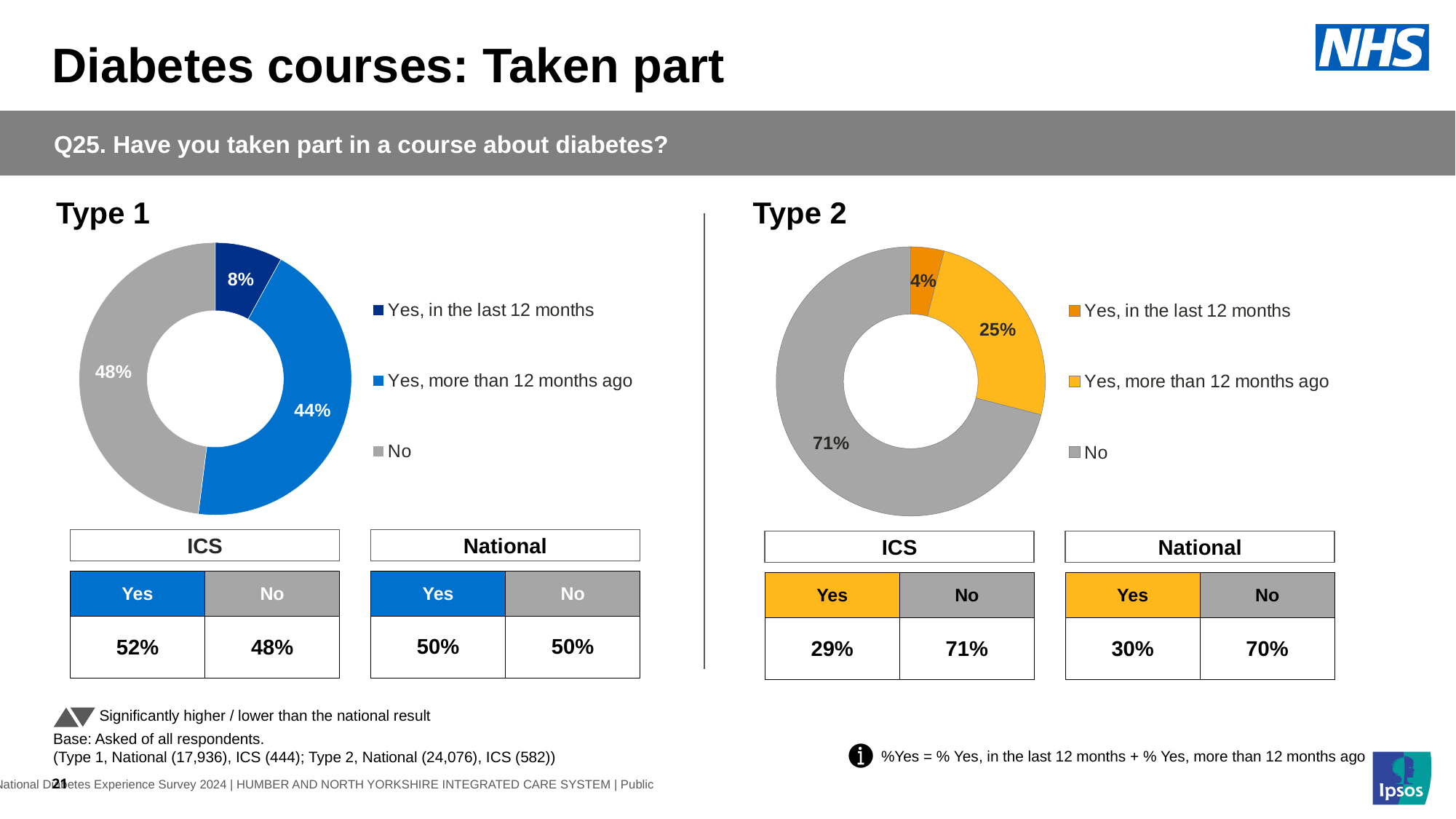
In the Type 1 chart, what percentage of respondents answered 'Yes, more than 12 months ago'? 44% In the Type 1 chart, which response category has the largest share? No Which is larger: the 'Yes, in the last 12 months' share in the Type 1 chart or in the Type 2 chart? Type 1 What kind of chart is used for the Type 1 data? Doughnut (pie) chart In the Type 2 chart, what percentage of respondents answered 'Yes, more than 12 months ago'? 25% In the Type 1 chart, what percentage of respondents answered 'Yes, in the last 12 months'? 8% In the Type 1 chart, what is the difference between the 'No' share and the 'Yes, more than 12 months ago' share? 4 percentage points In the Type 2 chart, what is the difference between the 'No' share and the 'Yes, more than 12 months ago' share? 46 percentage points In the Type 2 chart, what colour represents the 'No' category? Grey How many response categories does the Type 2 chart's legend list? 3 In the Type 2 chart, what percentage of respondents answered 'No'? 71% In the Type 2 chart, which response category has the smallest share? Yes, in the last 12 months